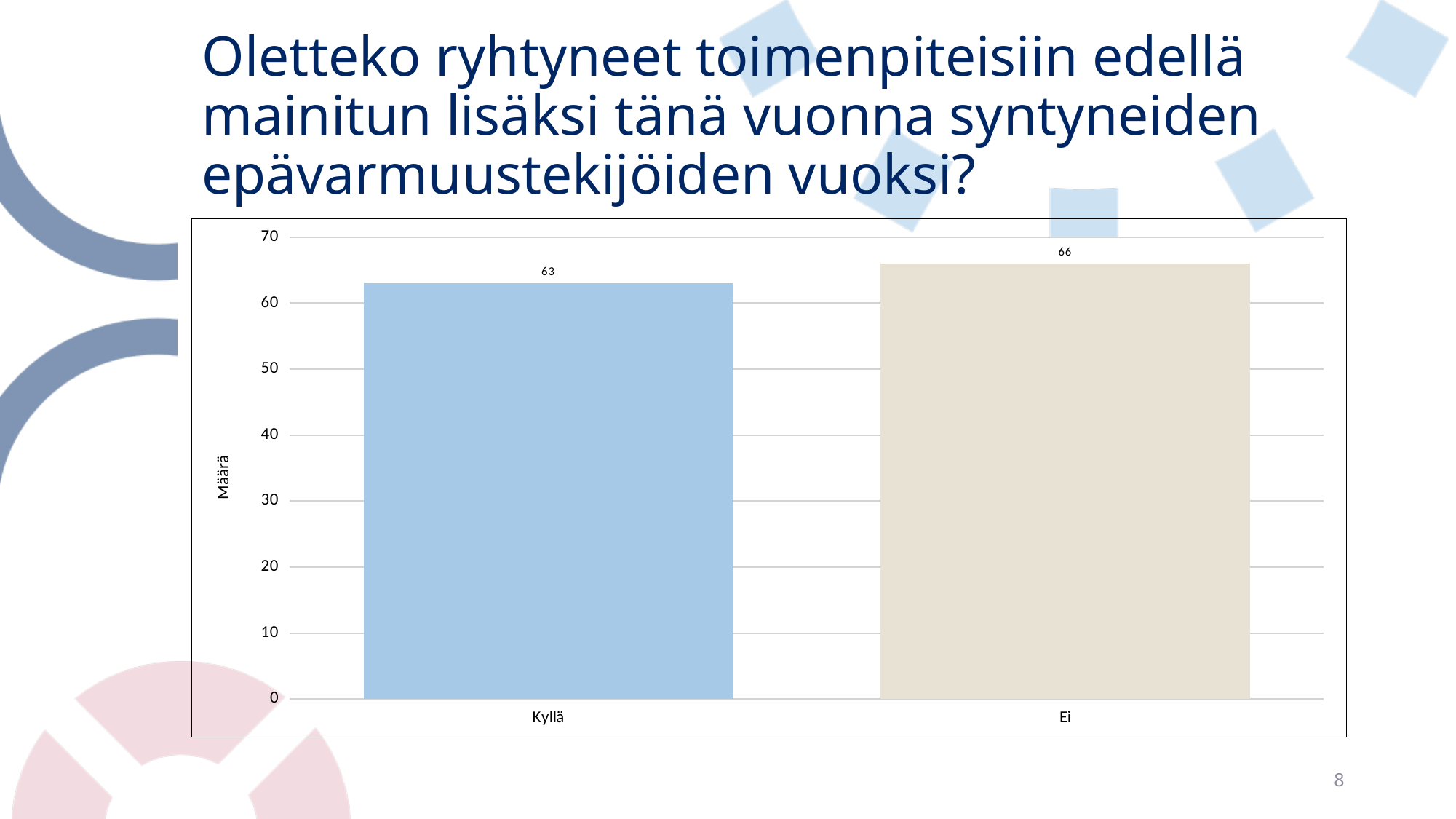
What is the label of the vertical axis? Määrä What is the difference between the values for Ei and Kyllä? 3 What is the total of the values for Kyllä and Ei? 129 What kind of chart is shown on the slide? bar chart Which category has the lowest value? Kyllä What is the value for Ei? 66 Is the value for Kyllä greater or less than 60? greater Which is larger, the value for Kyllä or the value for Ei? Ei Is the value for Ei greater or less than 70? less Which category has the highest value? Ei How many categories are shown on the x axis? 2 What is the value for Kyllä? 63